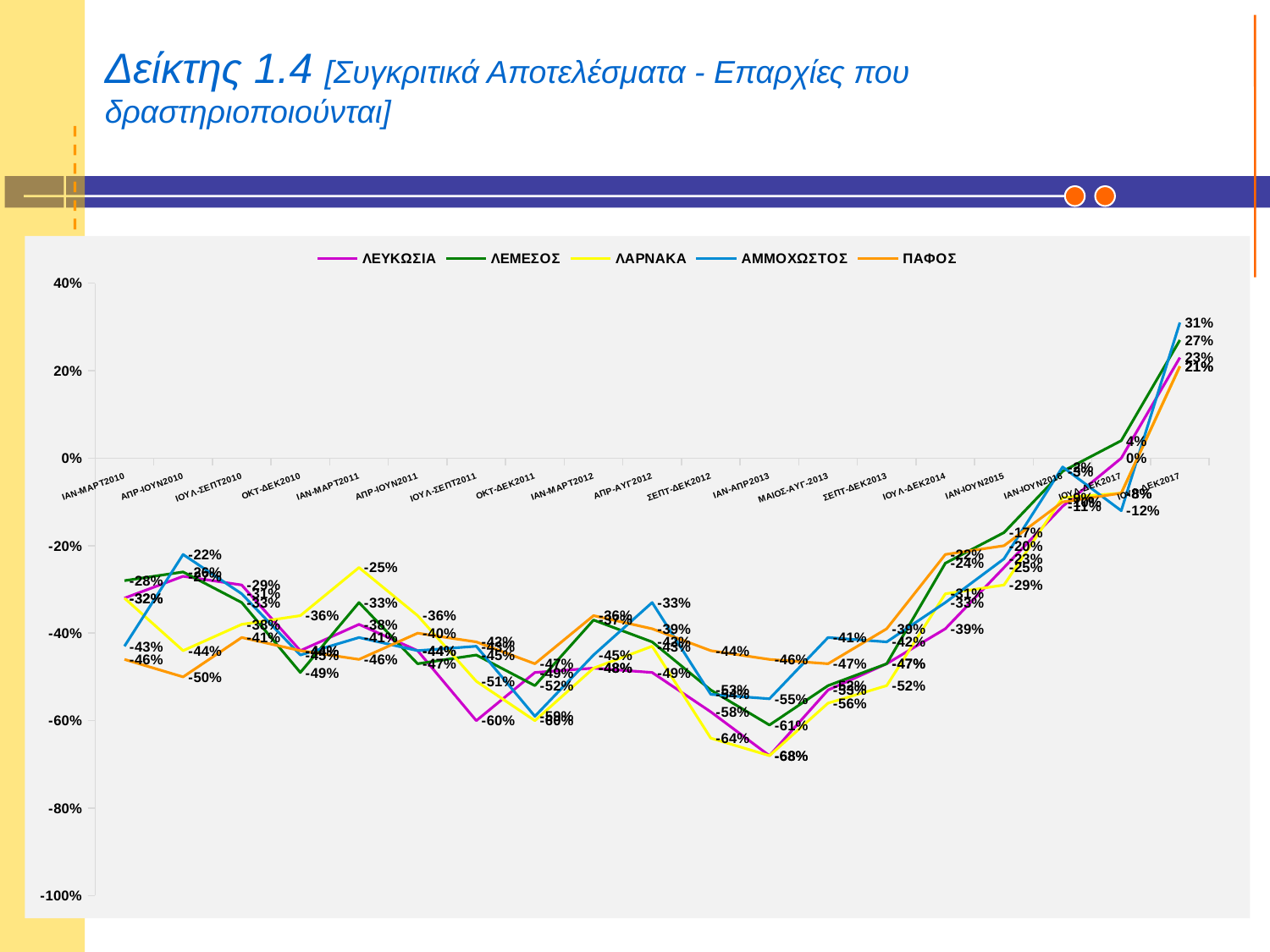
Is the value for ΑΜΜΟΧΩΣΤΟΣ at ΙΟΥΛ-ΣΕΠΤ2010 greater or less than -40%? greater What is the value for ΑΜΜΟΧΩΣΤΟΣ at ΙΟΥΛ-ΣΕΠΤ2010? -31% What is the lowest value labelled anywhere on the chart? -68% How many series does the legend list? 5 What kind of chart is shown on the slide? line chart Which series is plotted in yellow? ΛΑΡΝΑΚΑ What is the value for ΛΑΡΝΑΚΑ at ΑΠΡ-ΙΟΥΝ2011? -36% What is the value for ΠΑΦΟΣ at ΑΠΡ-ΙΟΥΝ2010? -50%